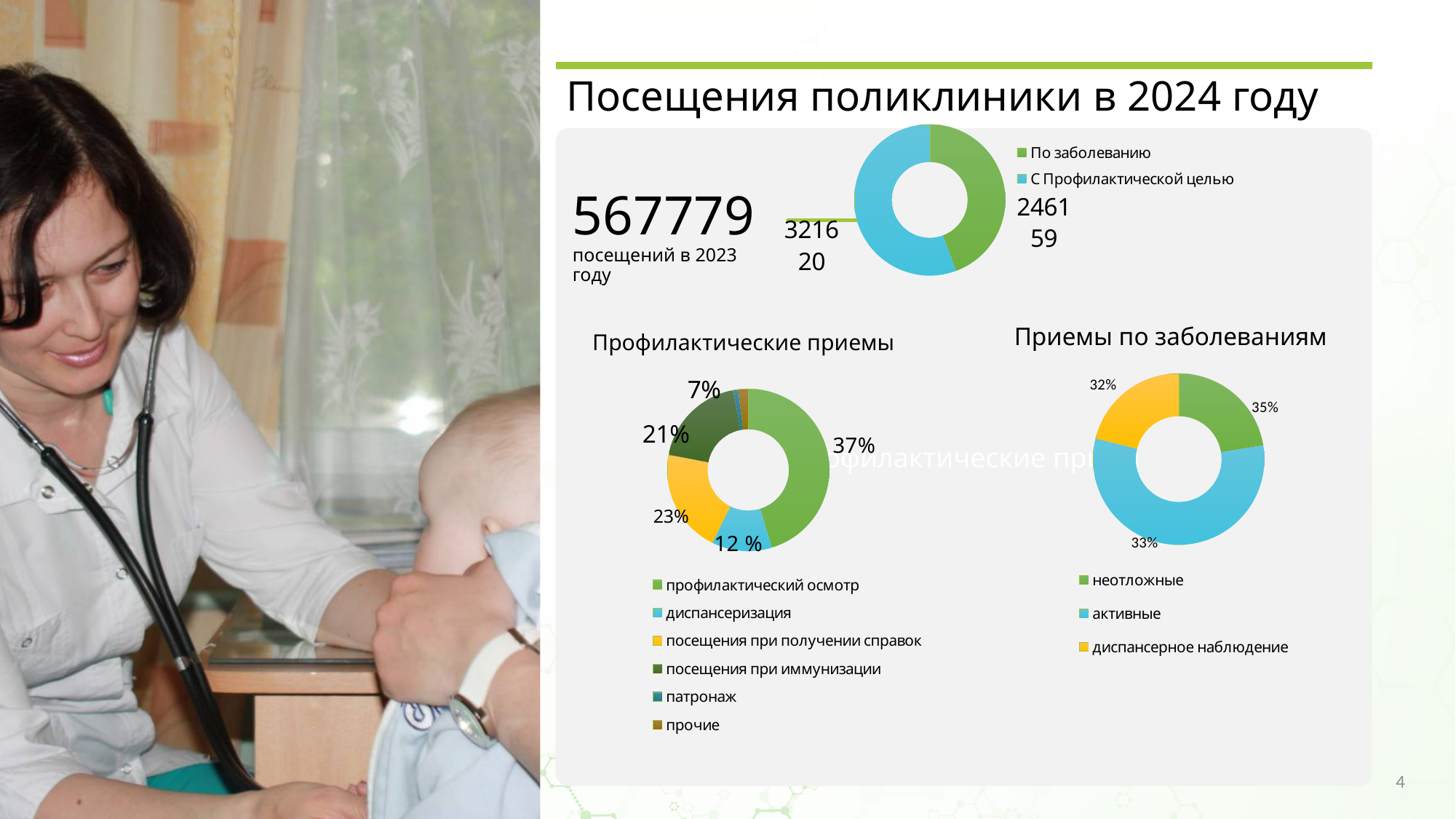
How many charts are on the slide? 3 In the 'Профилактические приемы' chart, what is the share for 'посещения при получении справок'? 23% In the 'Приемы по заболеваниям' chart, what is the share for 'неотложные'? 35% In the 'Приемы по заболеваниям' chart, what is the share for 'диспансерное наблюдение'? 32% In the 'Профилактические приемы' chart, which category has the largest share? профилактический осмотр In the top chart, which category is larger: 'По заболеванию' or 'С Профилактической целью'? С Профилактической целью How many categories does the legend of the 'Профилактические приемы' chart list? 6 In the 'Профилактические приемы' chart, what is the share for 'диспансеризация'? 12 % How many series does the legend of the top chart list? 2 In the 'Профилактические приемы' chart, what is the share for 'профилактический осмотр'? 37% What kind of chart is the 'Профилактические приемы' chart? doughnut chart How many categories does the legend of the 'Приемы по заболеваниям' chart list? 3